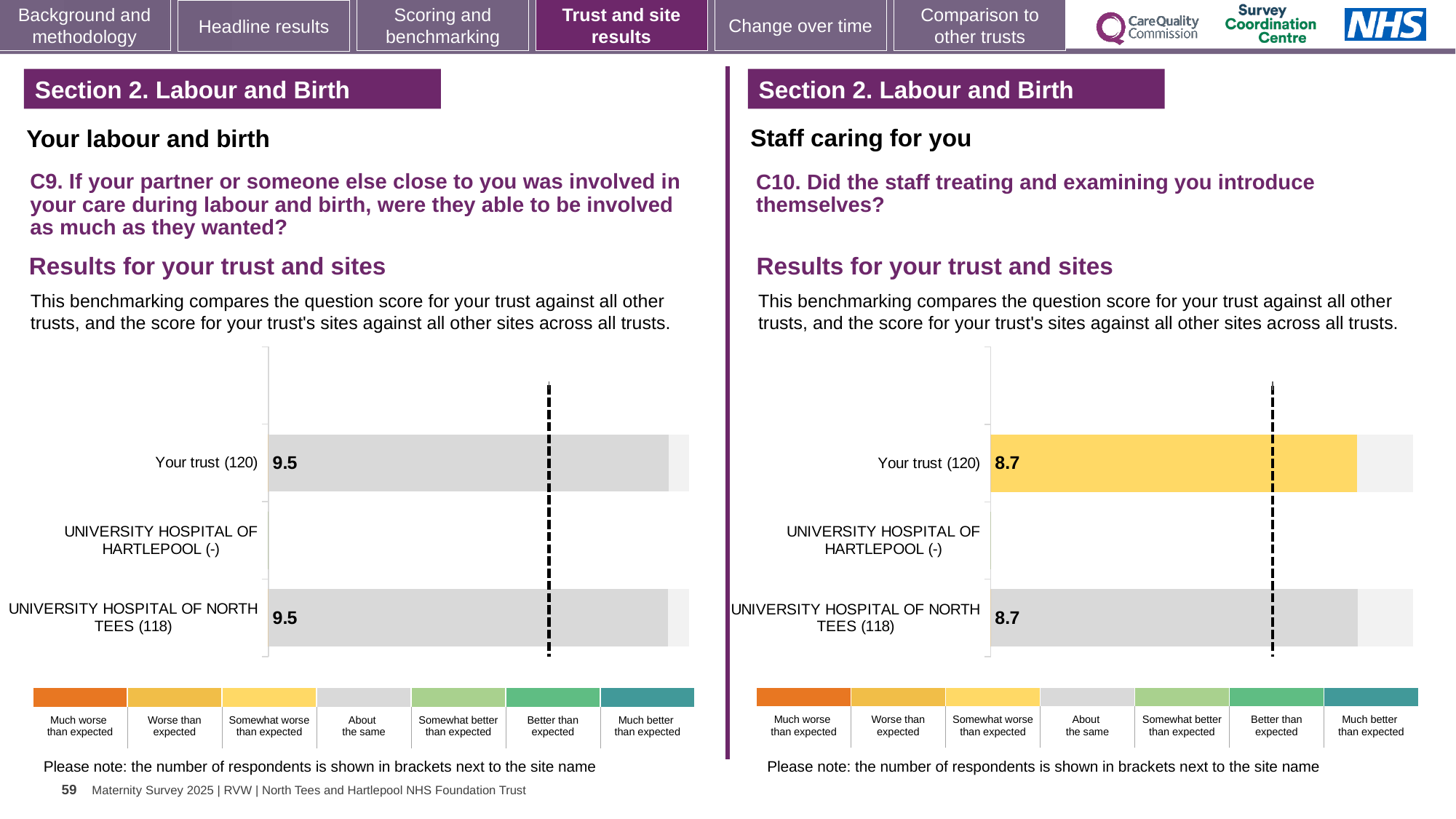
In the C10 chart on the right, what colour is the bar for Your trust (120)? Yellow In the C10 chart on the right, which category has no bar plotted? UNIVERSITY HOSPITAL OF HARTLEPOOL (-) In the C9 chart on the left, what is the score for Your trust (120)? 9.5 In the C10 chart on the right, what is the score for UNIVERSITY HOSPITAL OF NORTH TEES (118)? 8.7 In the C9 chart on the left, what is the score for UNIVERSITY HOSPITAL OF NORTH TEES (118)? 9.5 In the C10 chart on the right, what is the score for Your trust (120)? 8.7 In the C10 chart on the right, what is the difference between the score for Your trust (120) and the score for UNIVERSITY HOSPITAL OF NORTH TEES (118)? 0 In the C10 chart on the right, how many categories are listed on the vertical axis? 3 In the C9 chart on the left, how many categories are listed on the vertical axis? 3 In the C9 chart on the left, what is the difference between the score for Your trust (120) and the score for UNIVERSITY HOSPITAL OF NORTH TEES (118)? 0 How many respondents are shown in brackets for UNIVERSITY HOSPITAL OF NORTH TEES in the C9 chart on the left? 118 What kind of chart is the C9 chart on the left? Bar chart